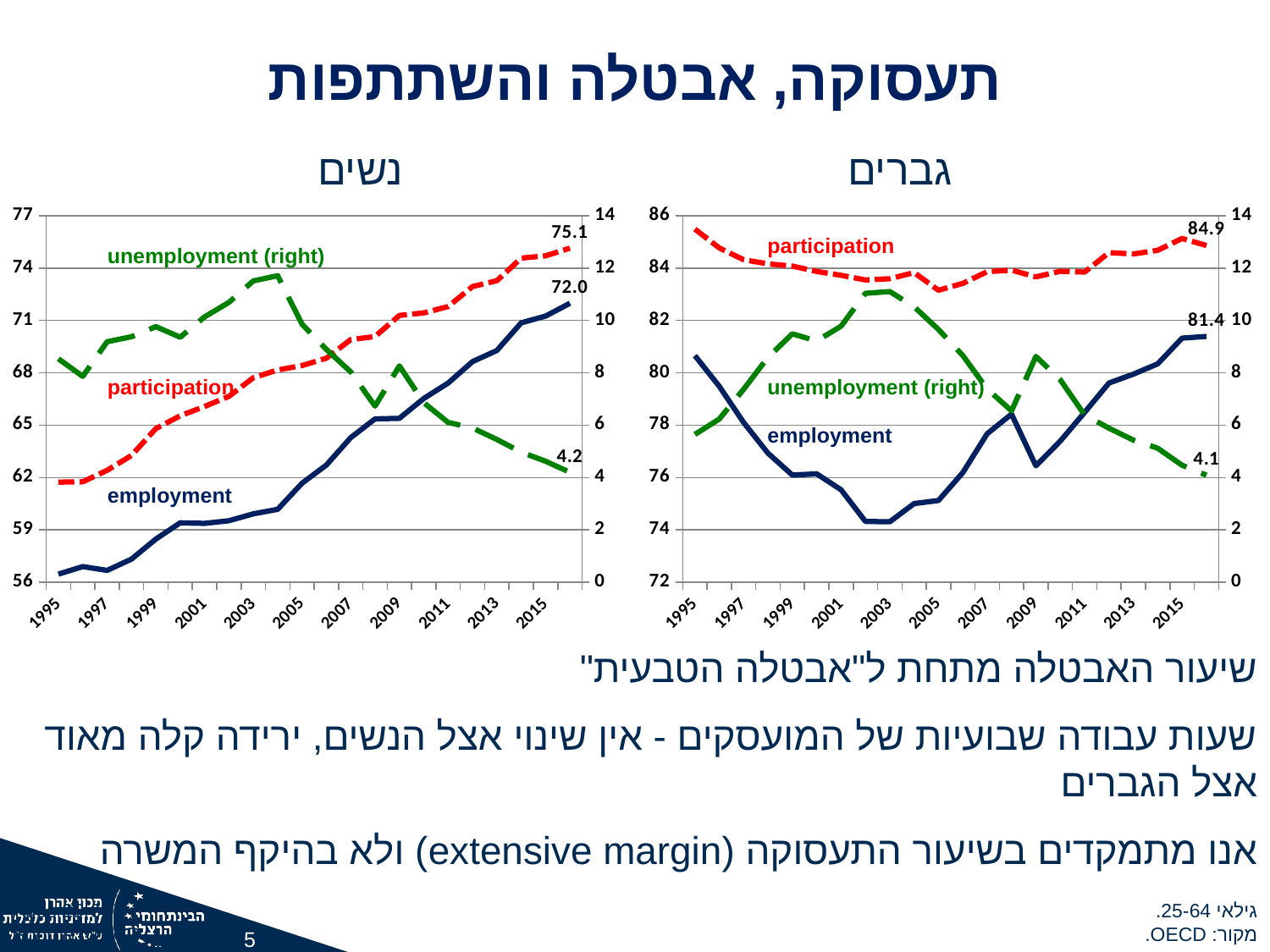
In the left chart (נשים), what is the labelled final value of the participation series? 75.1 In the right chart (גברים), what is the labelled final value of the unemployment (right) series? 4.1 In the left chart (נשים), what is the labelled final value of the unemployment (right) series? 4.2 In the left chart (נשים), what is the difference between the labelled final participation value and the labelled final employment value? 3.1 In the right chart (גברים), is the employment value in 2003 greater or less than 76? less In the right chart (גברים), what is the labelled final value of the participation series? 84.9 How many data series are plotted in each chart? 3 In the right chart (גברים), what is the labelled final value of the employment series? 81.4 What kind of chart is used for the two charts on the slide? Line chart In the left chart (נשים), what is the labelled final value of the employment series? 72.0 In the right chart (גברים), what is the difference between the labelled final participation value and the labelled final employment value? 3.5 Does the employment series in the left chart (נשים) generally rise or fall from 1995 to 2016? Rise